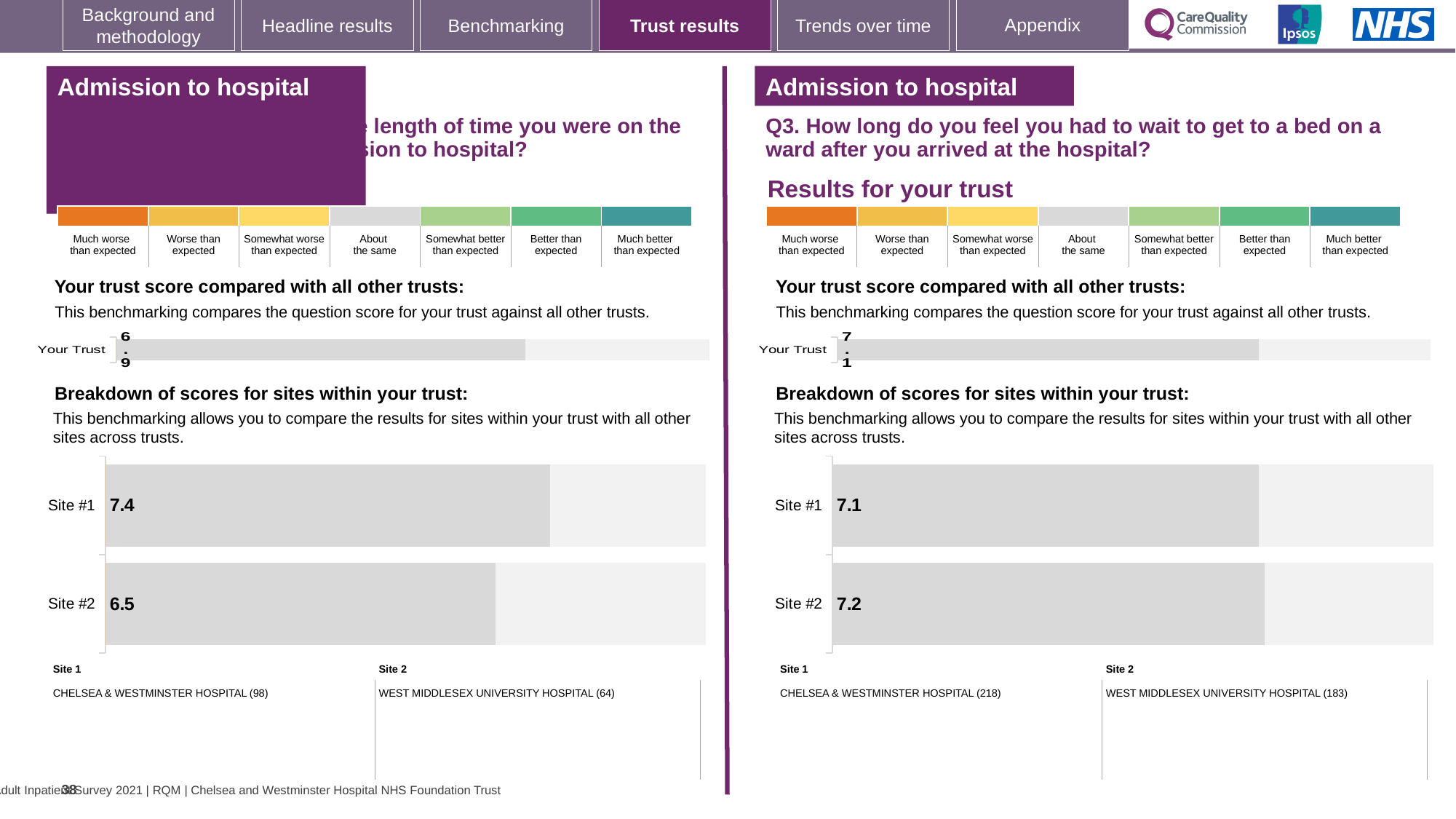
In the left panel's 'Breakdown of scores for sites within your trust' chart, what is the score for Site #2? 6.5 In the Q3 panel's 'Breakdown of scores for sites within your trust' chart, what is the score for Site #1? 7.1 In the left panel's site breakdown chart, which site has the higher score? Site #1 What kind of chart is used for the site breakdown in the Q3 panel? Bar chart In the left panel's site breakdown chart, what is the difference between the Site #1 and Site #2 scores? 0.9 In the Q3 panel's site breakdown chart, what is the difference between the Site #2 and Site #1 scores? 0.1 In the left panel's 'Your trust score compared with all other trusts' chart, what is the score for Your Trust? 6.9 In the left panel's site breakdown chart, is the Site #2 score larger or smaller than the Your Trust score of 6.9? Smaller In the Q3 panel's 'Your trust score compared with all other trusts' chart, what is the score for Your Trust? 7.1 In the left panel's 'Breakdown of scores for sites within your trust' chart, what is the score for Site #1? 7.4 How many sites are shown in the Q3 panel's site breakdown chart? 2 In the Q3 panel's 'Breakdown of scores for sites within your trust' chart, what is the score for Site #2? 7.2